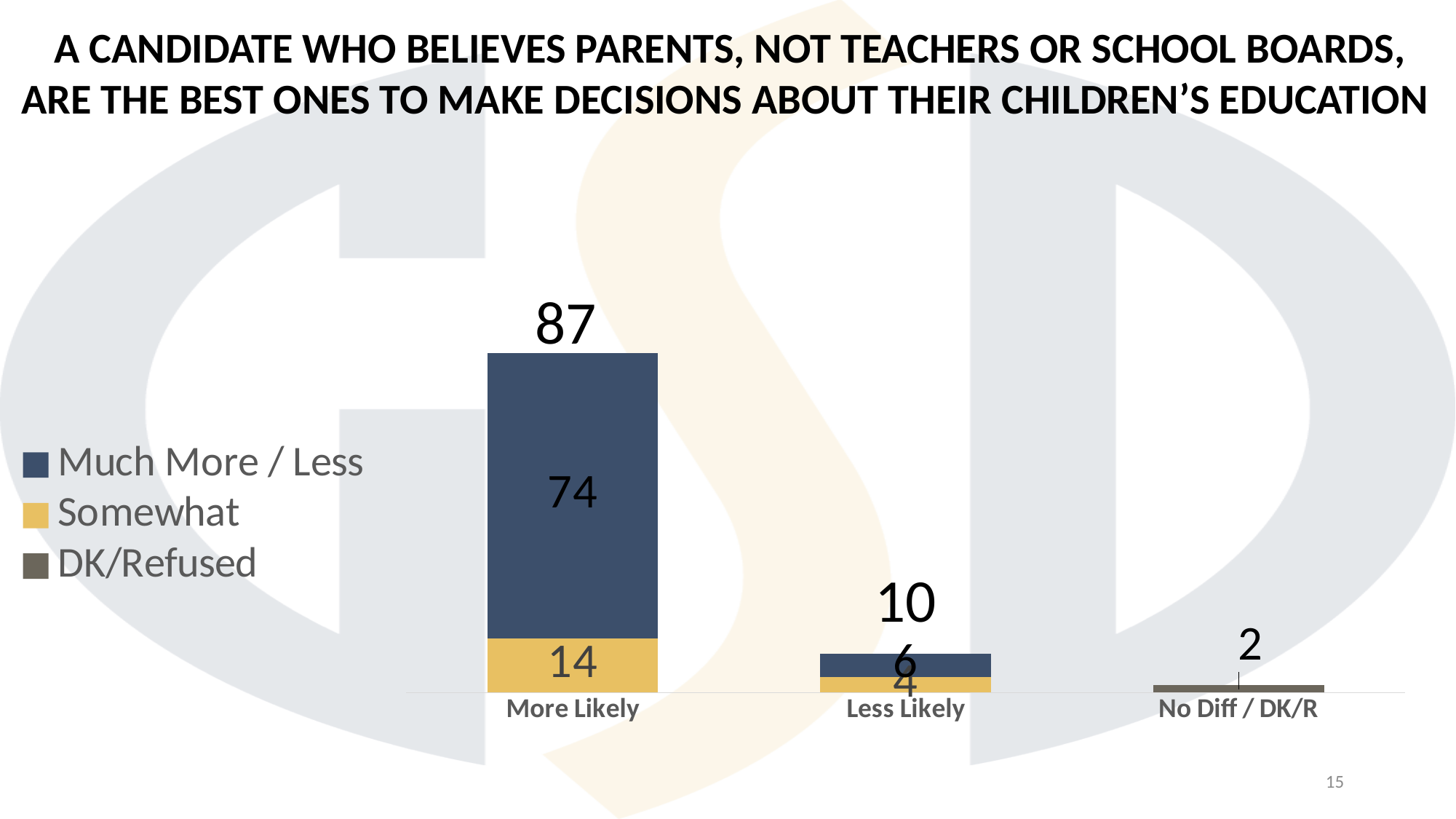
What is the Somewhat value for More Likely? 14 What is the Much More / Less value for More Likely? 74 What is the Somewhat value for Less Likely? 4 What is the total value shown above the Less Likely bar? 10 Which category has the lowest total? No Diff / DK/R How many series does the legend list? 3 Which category has the highest total? More Likely What is the difference between the More Likely total and the Less Likely total? 77 What is the value for No Diff / DK/R? 2 What kind of chart is shown on the slide? Stacked bar chart What is the Much More / Less value for Less Likely? 6 What is the total value shown above the More Likely bar? 87